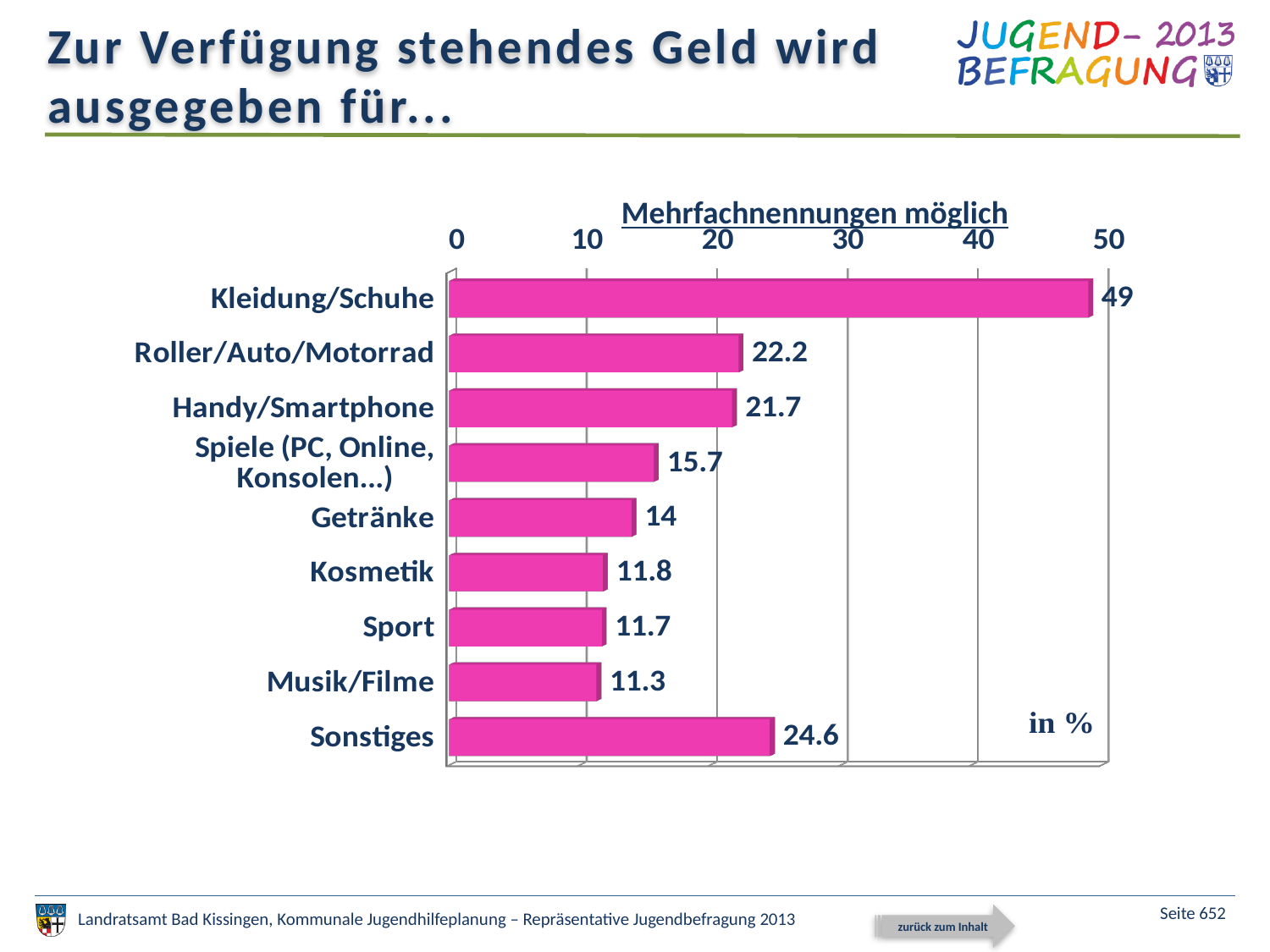
Which is larger, the value for Getränke or the value for Kosmetik? Getränke How many categories are shown in the chart? 9 What is the difference between the values for Kleidung/Schuhe and Sonstiges? 24.4 What is the value for Kleidung/Schuhe? 49 What is the difference between the values for Roller/Auto/Motorrad and Handy/Smartphone? 0.5 Which category has the highest value? Kleidung/Schuhe What is the value for Handy/Smartphone? 21.7 What note is printed above the chart's axis? Mehrfachnennungen möglich Is the value for Spiele (PC, Online, Konsolen...) greater or less than 20? less Which category has the lowest value? Musik/Filme What kind of chart is shown on the slide? bar chart What is the value for Sonstiges? 24.6